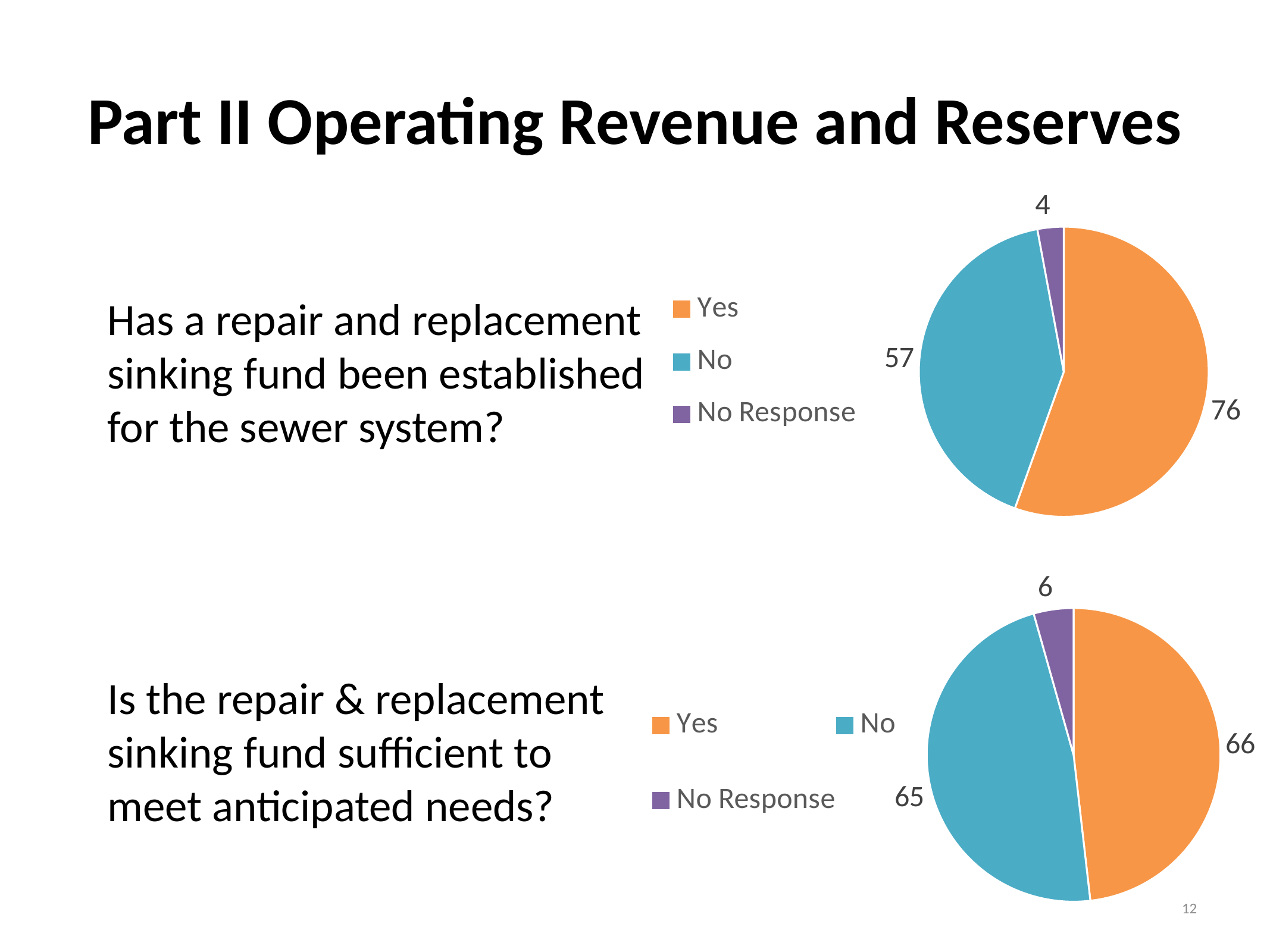
In the bottom pie chart (sinking fund sufficient to meet anticipated needs), what is the value for No Response? 6 In the bottom pie chart, which category has the smallest slice? No Response In the top pie chart, which category has the largest slice? Yes What type of chart is used for the top chart on the slide? Pie chart In the top pie chart (sewer system sinking fund established), what is the value for No Response? 4 In the top pie chart (sewer system sinking fund established), what is the value for Yes? 76 How many categories does the bottom pie chart show? 3 In the top pie chart (sewer system sinking fund established), what is the value for No? 57 In the bottom pie chart, is the value for Yes or No larger? Yes In the bottom pie chart (sinking fund sufficient to meet anticipated needs), what is the value for Yes? 66 In the top pie chart, what is the difference between the Yes and No values? 19 In the top pie chart, what colour is the No slice? Blue